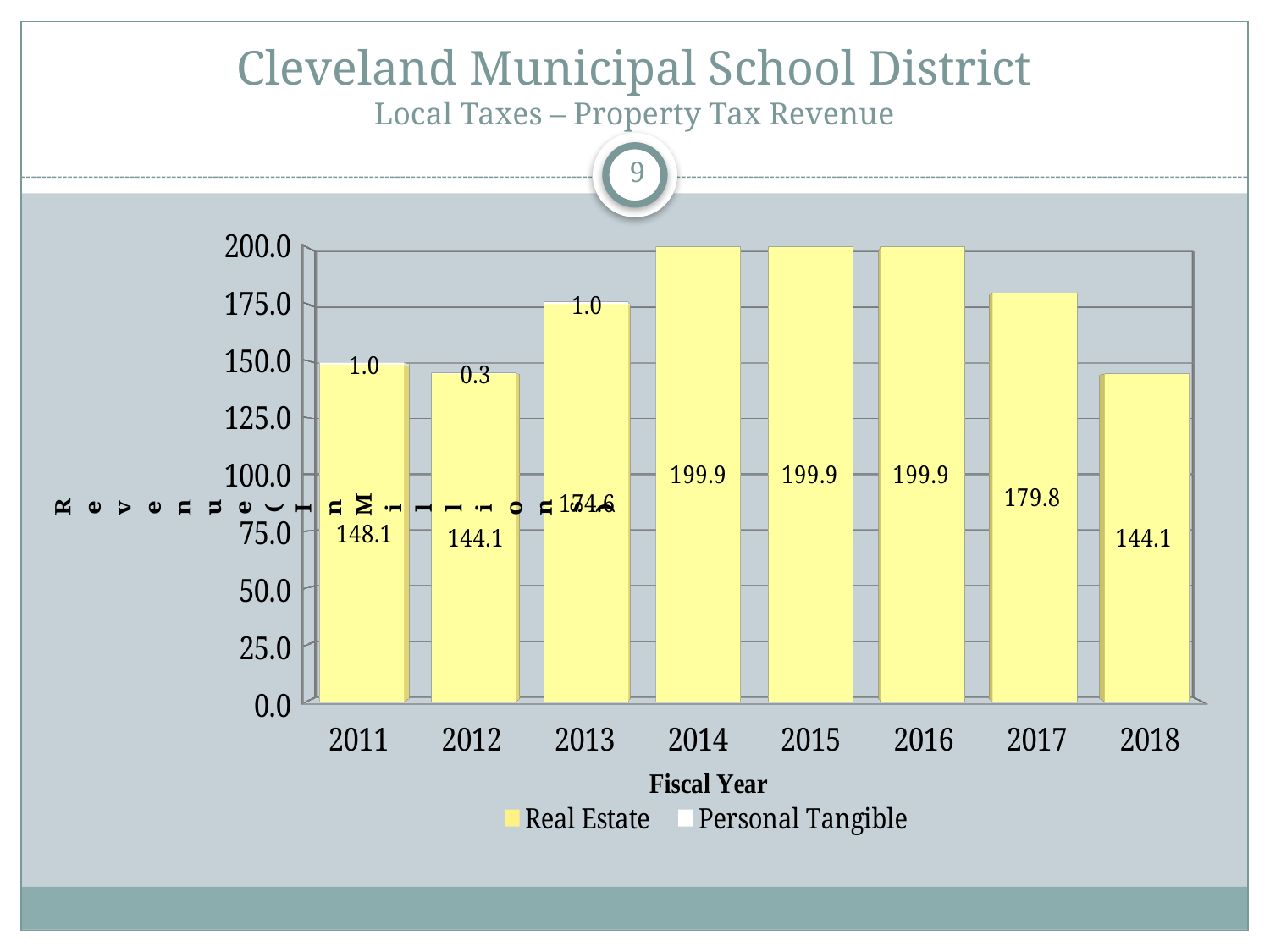
What kind of chart is shown on the slide? bar chart How many series does the legend list? 2 What is the Real Estate value for fiscal year 2018? 144.1 How many fiscal years are shown on the x axis? 8 Which fiscal year has the larger Real Estate value, 2011 or 2012? 2011 What is the difference between the Real Estate values for 2017 and 2018? 35.7 Do the Real Estate values rise or fall from 2016 to 2018? fall What is the Real Estate value for fiscal year 2017? 179.8 What is the total of the stacked bar for fiscal year 2011 (Real Estate plus Personal Tangible)? 149.1 What is the Personal Tangible value for fiscal year 2011? 1.0 What is the title of the x axis? Fiscal Year What is the Personal Tangible value for fiscal year 2012? 0.3